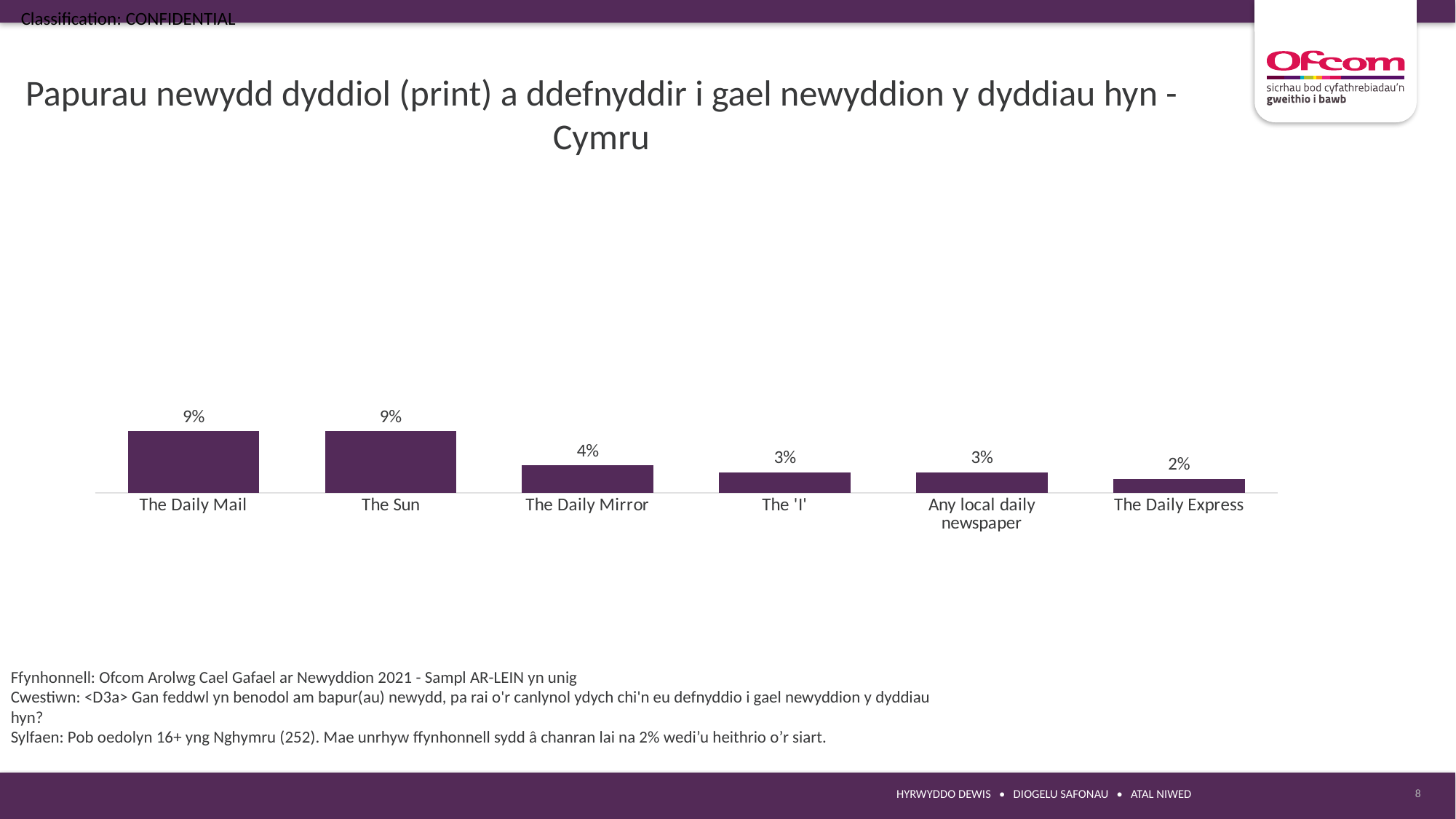
Which category has the lowest value? The Daily Express What is the value for The Daily Express? 2% What is the value for Any local daily newspaper? 3% How many categories are shown in the chart? 6 What is the difference between the values for The Daily Mirror and The Daily Express? 2% What is the difference between the values for The Sun and The Daily Mirror? 5% What is the value for The Daily Mail? 9% Which two categories share the highest value of 9%? The Daily Mail and The Sun What kind of chart is shown on the slide? Bar chart Do the values rise or fall from left to right across the categories? Fall What is the value for The Daily Mirror? 4% Which is larger, the value for The Daily Mirror or the value for The 'I'? The Daily Mirror